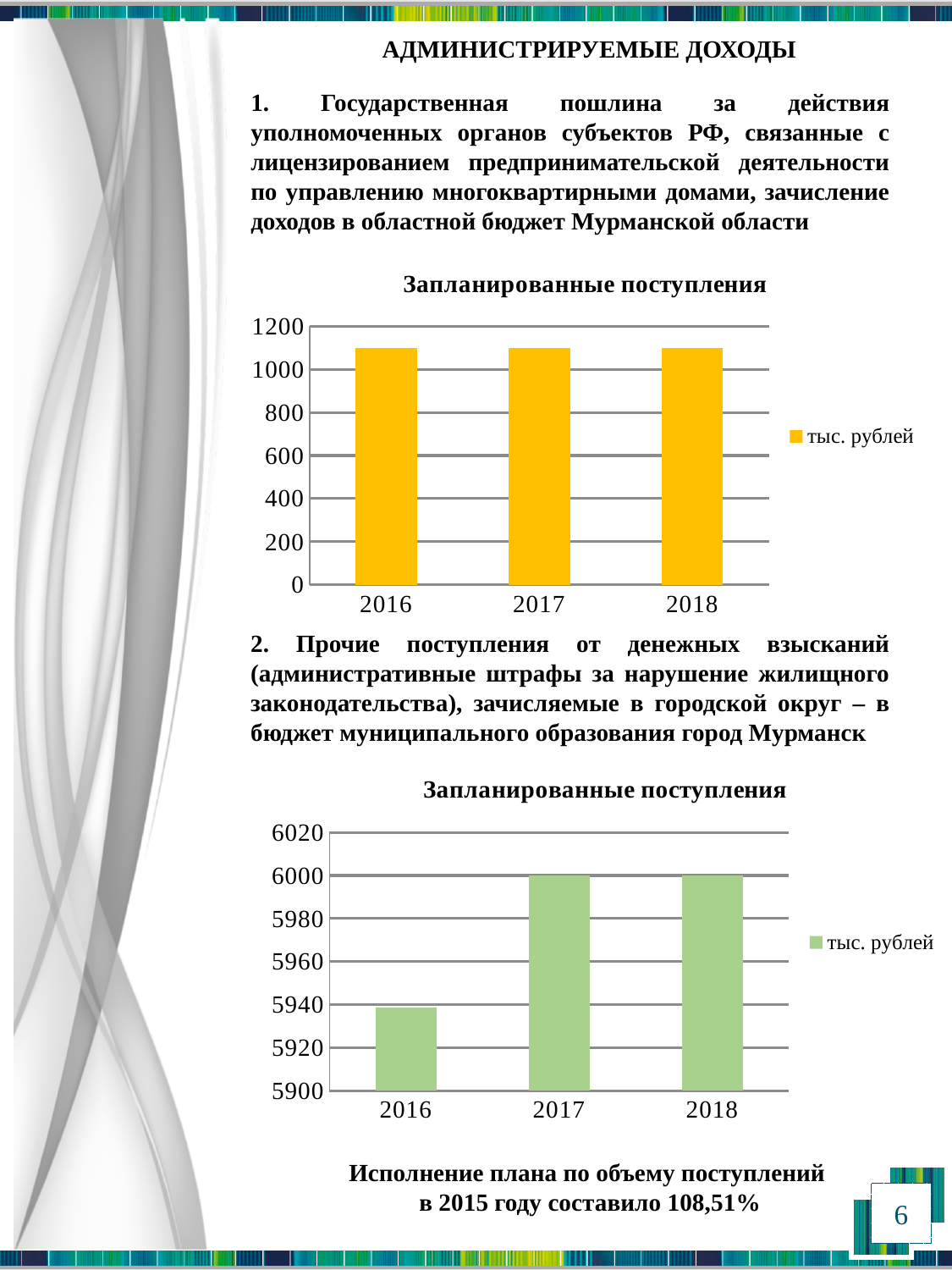
How many series does the legend of the top chart list? 1 What colour are the bars in the bottom chart? green How many years are shown on the x axis of the top chart? 3 In the top chart, is the value for 2018 greater or less than 1200? less In the bottom chart, what is the value for 2017? 6000 What kind of chart is the top chart on the slide? bar chart In the bottom chart, which year has the lowest value? 2016 What is the legend entry of the bottom chart? тыс. рублей In the bottom chart, which is larger, the value for 2016 or the value for 2018? 2018 In the bottom chart, is the value for 2016 greater or less than 5960? less In the top chart, do the values rise, fall or stay the same from 2016 to 2018? stay the same In the top chart, is the value for 2017 greater or less than 1000? greater